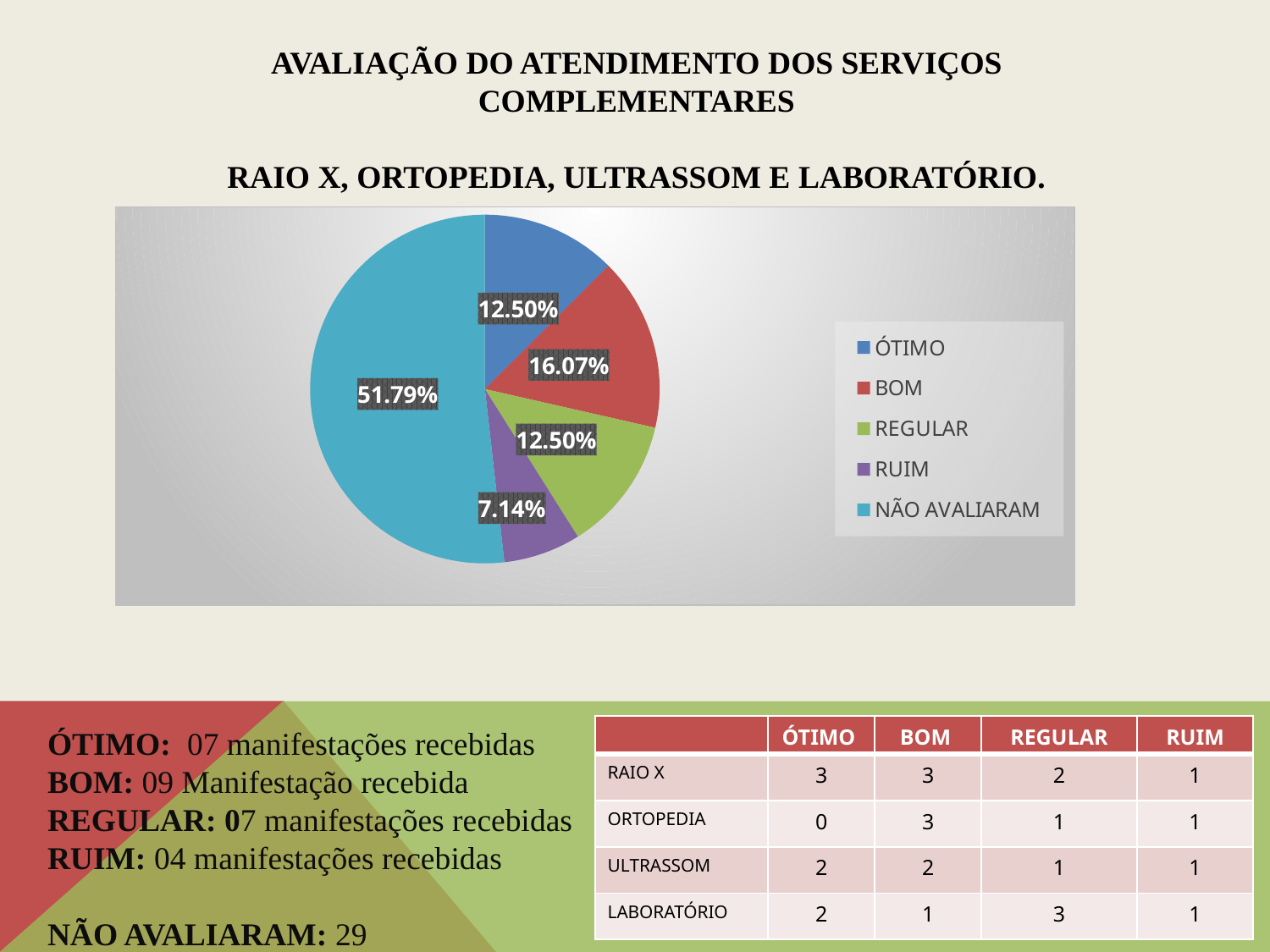
What percentage of the pie does NÃO AVALIARAM represent? 51.79% How many slices does the pie chart have? 5 How many entries does the legend list? 5 What percentage of the pie does BOM represent? 16.07% What is the difference in percentage points between NÃO AVALIARAM and BOM? 35.72 Which category has the largest slice of the pie? NÃO AVALIARAM What is the difference in percentage points between BOM and RUIM? 8.93 What percentage of the pie does RUIM represent? 7.14% Which category has the smallest slice of the pie? RUIM What kind of chart is shown on the slide? pie chart What percentage of the pie does ÓTIMO represent? 12.50% Which slice is larger, BOM or REGULAR? BOM